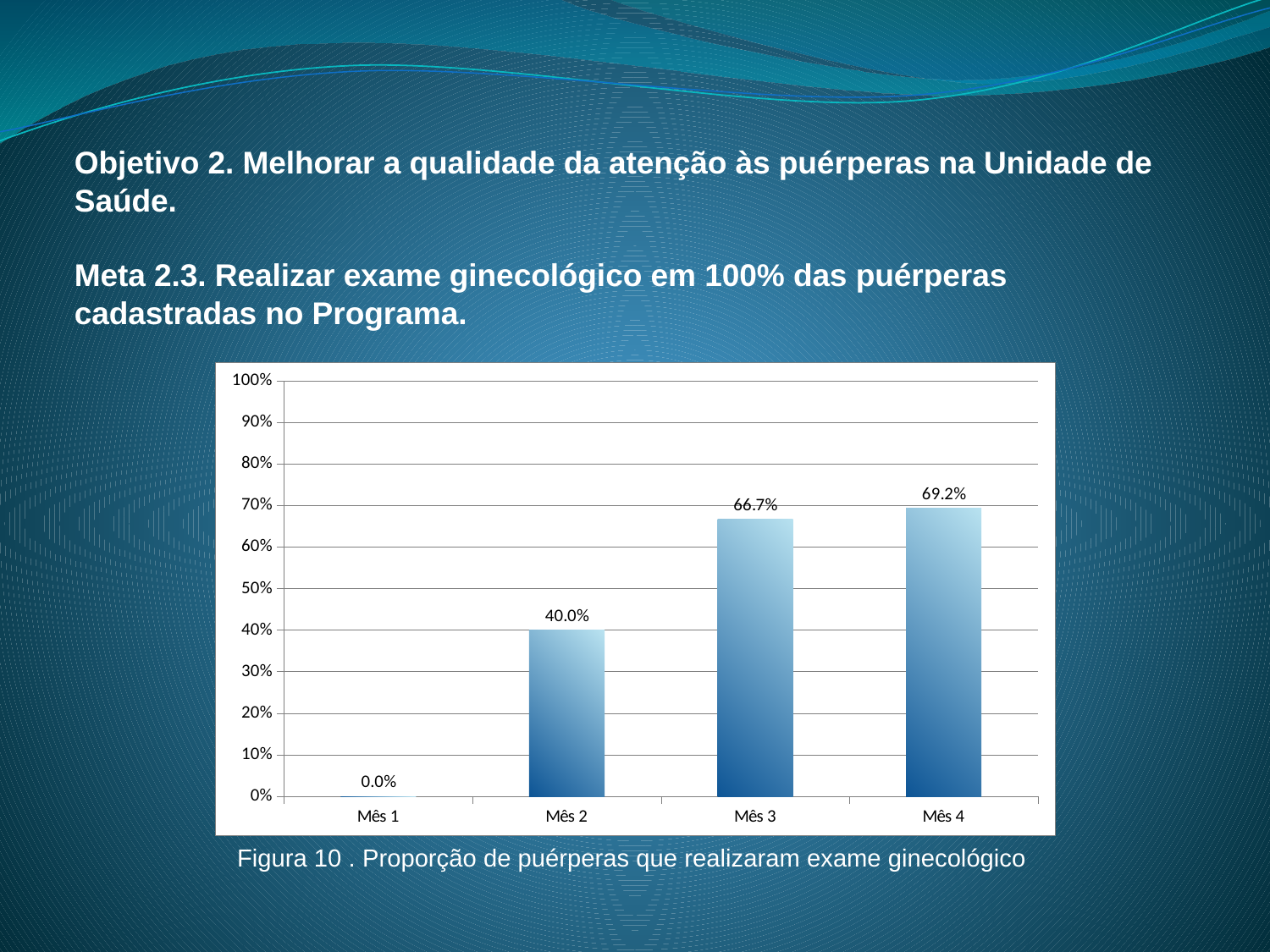
Which month has the highest value? Mês 4 How many months are shown on the x axis? 4 Is the value for Mês 4 greater or less than 60%? greater What is the value for Mês 2? 40.0% What is the value for Mês 4? 69.2% What is the difference between the values for Mês 3 and Mês 2? 26.7% Do the values rise or fall from Mês 1 to Mês 4? Rise Which month has the lowest value? Mês 1 What kind of chart is shown on the slide? Bar chart Which is larger, the value for Mês 2 or the value for Mês 3? Mês 3 What is the value for Mês 1? 0.0% What is the value for Mês 3? 66.7%